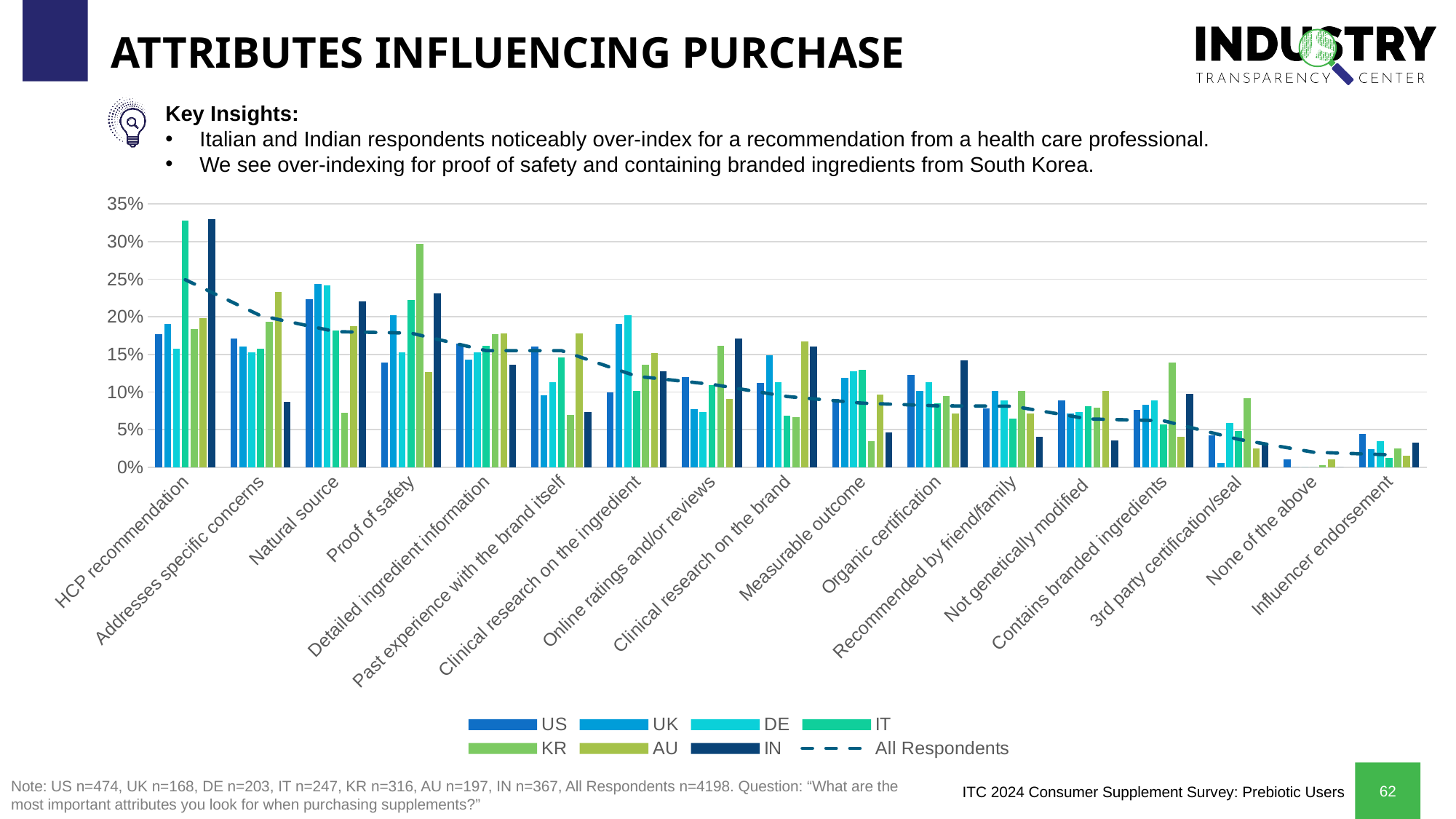
For Proof of safety, which is larger: the value for KR or the value for US? KR Which series is shown as a dashed line rather than bars? All Respondents Which country has the highest value for Proof of safety? KR Is the value for US on None of the above greater or less than 5%? less How many entries does the legend list? 8 Which country has the lowest value for Measurable outcome? KR Is the value for KR on Contains branded ingredients greater or less than 10%? greater Is the value for US on Natural source greater or less than 20%? greater How many attribute categories are shown along the x axis? 17 Does the All Respondents dashed line rise or fall from left to right across the categories? Fall What kind of chart is shown on the slide? Bar chart (with a dashed line for All Respondents)